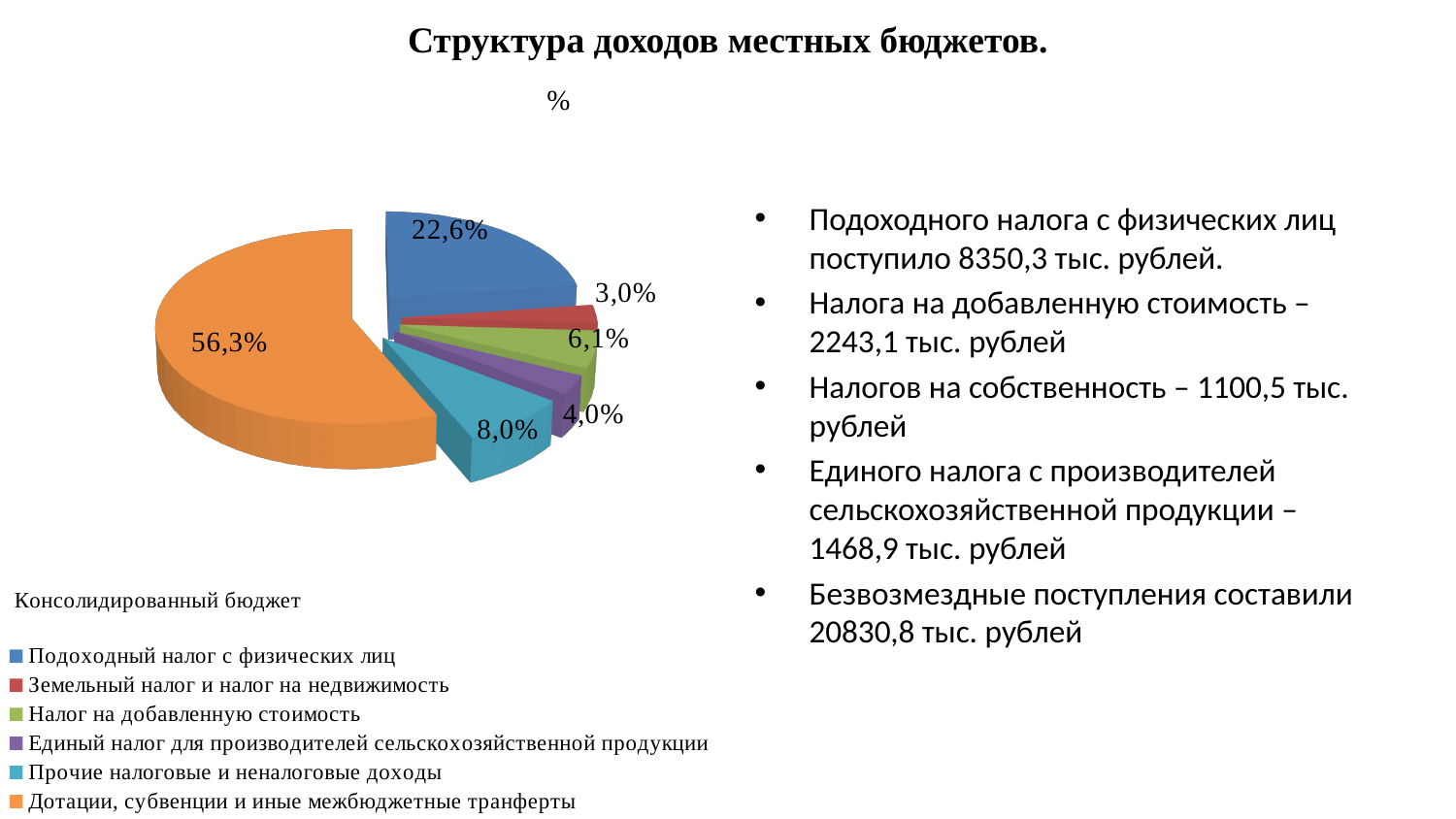
What share of the pie does "Подоходный налог с физических лиц" represent? 22,6% What share of the pie does "Земельный налог и налог на недвижимость" represent? 3,0% How many categories does the legend of the pie chart list? 6 What colour is the slice for "Единый налог для производителей сельскохозяйственной продукции"? purple What share of the pie does "Дотации, субвенции и иные межбюджетные трансферты" represent? 56,3% What share of the pie does "Налог на добавленную стоимость" represent? 6,1% Which category has the smallest slice of the pie? Земельный налог и налог на недвижимость What is the difference in percentage points between "Дотации, субвенции и иные межбюджетные трансферты" and "Подоходный налог с физических лиц"? 33,7 Which is larger: the slice for "Прочие налоговые и неналоговые доходы" or the slice for "Налог на добавленную стоимость"? Прочие налоговые и неналоговые доходы Which category has the largest slice of the pie? Дотации, субвенции и иные межбюджетные трансферты What type of chart is shown on the slide? pie chart What share of the pie does "Прочие налоговые и неналоговые доходы" represent? 8,0%